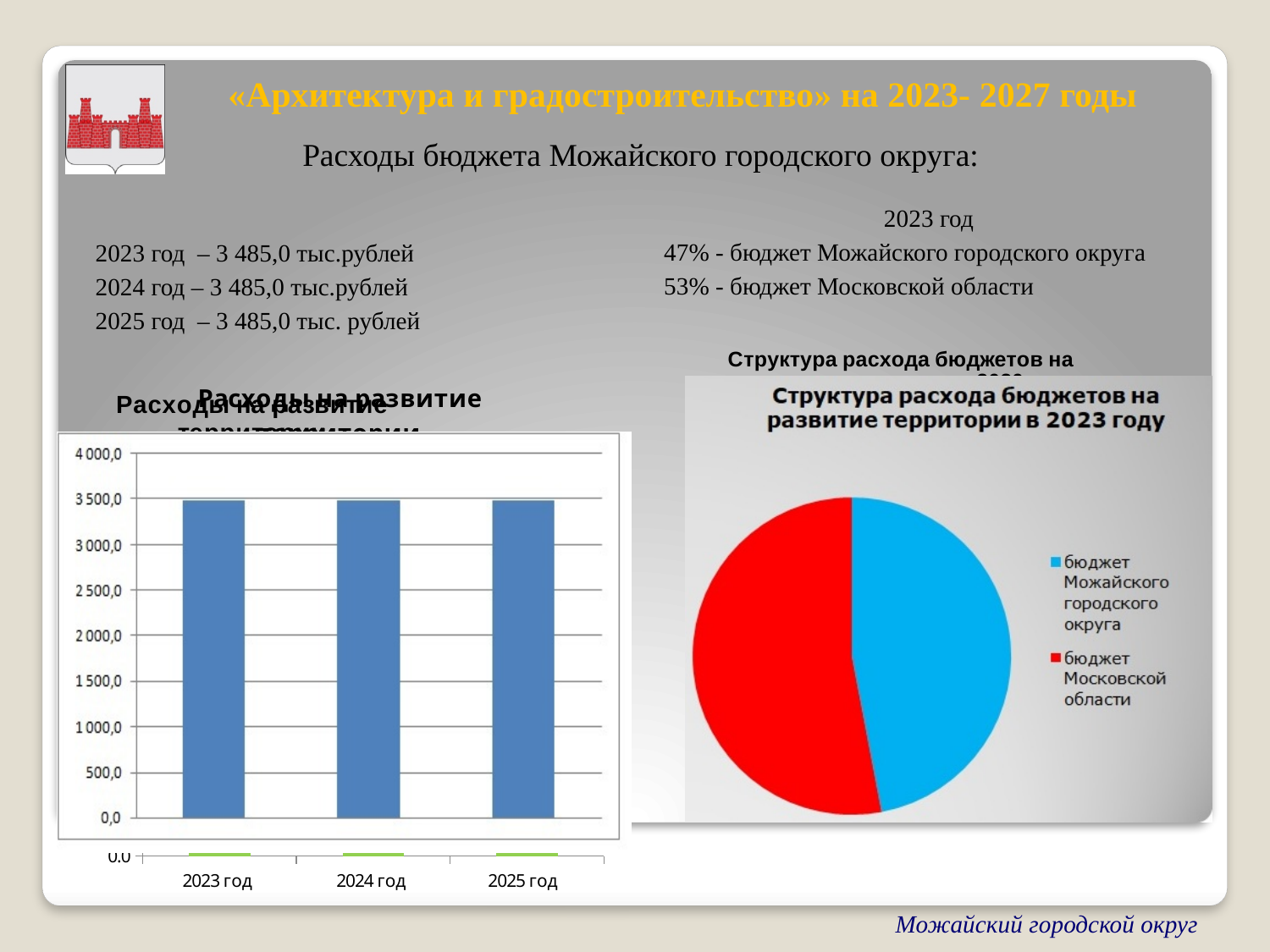
In the bar chart on the left, is the value for 2024 год greater or less than 2 500,0? greater What kind of chart is the chart on the left of the slide? bar chart In the bar chart on the left, is the value for 2025 год greater or less than 4 000,0? less Do the bar values in the bar chart on the left rise, fall or stay roughly the same from 2023 год to 2025 год? stay roughly the same According to the slide, what share of the pie chart on the right is бюджет Московской области? 53% Which years are shown on the x axis of the bar chart on the left? 2023 год, 2024 год, 2025 год How many entries does the legend of the pie chart on the right list? 2 What kind of chart is the chart on the right of the slide? pie chart How many bars does the bar chart on the left show? 3 What is the title of the pie chart on the right? Структура расхода бюджетов на развитие территории в 2023 году According to the slide, what share of the pie chart on the right is бюджет Можайского городского округа? 47% In the bar chart on the left, is the value for 2023 год greater or less than 3 000,0? greater